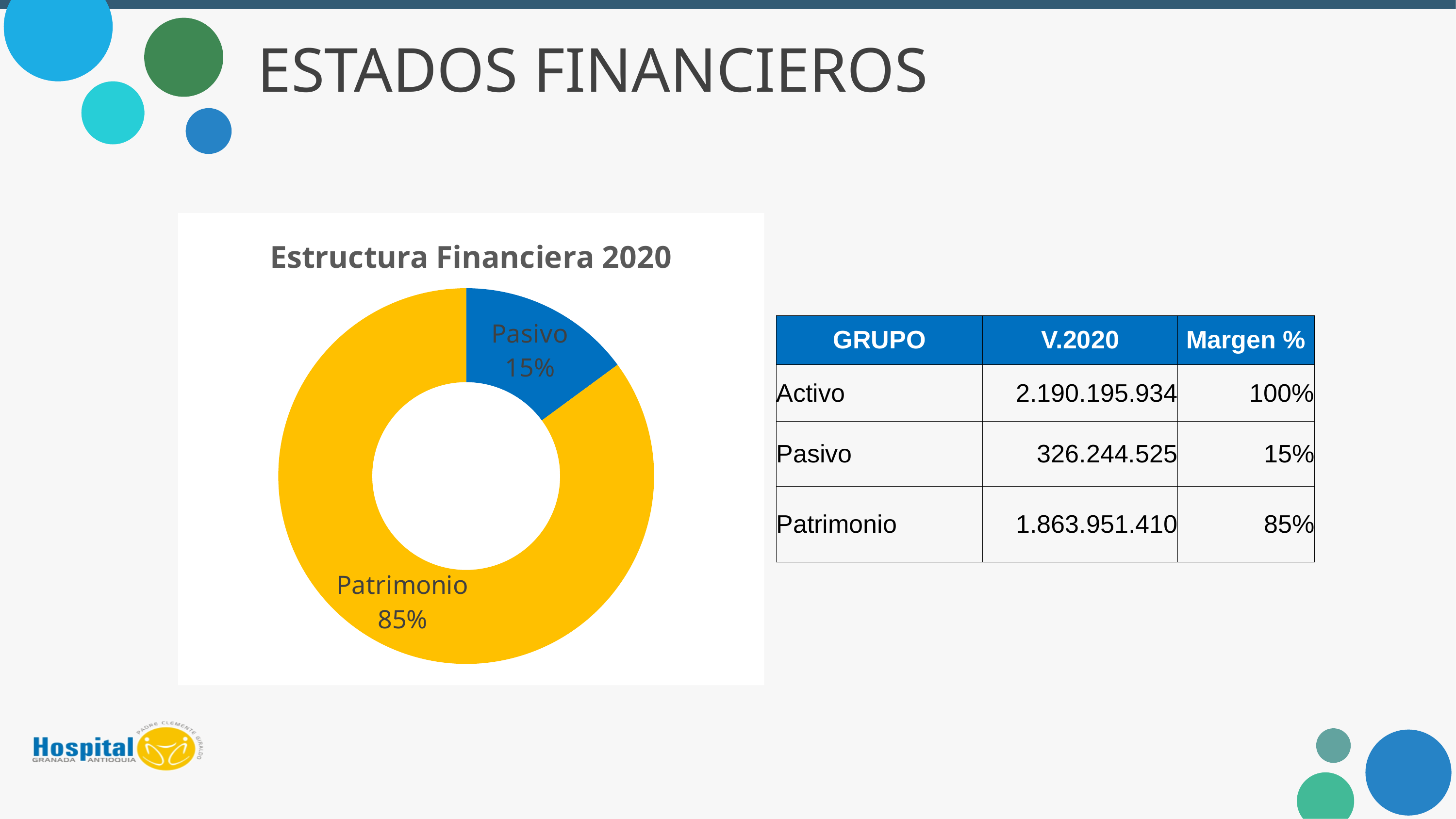
How many categories are shown in the chart? 2 What share of the chart does Pasivo represent? 15% Which category has the smallest share in the chart? Pasivo Which category has the largest share in the chart? Patrimonio What is the difference in percentage points between the Patrimonio and Pasivo shares? 70 What colour is the Pasivo slice in the chart? Blue Which is larger in the chart, Pasivo or Patrimonio? Patrimonio What share of the chart does Patrimonio represent? 85% What kind of chart is shown on the slide? Doughnut (pie) chart What is the title of the chart on the slide? Estructura Financiera 2020 What is the total of the two shares shown in the chart? 100%